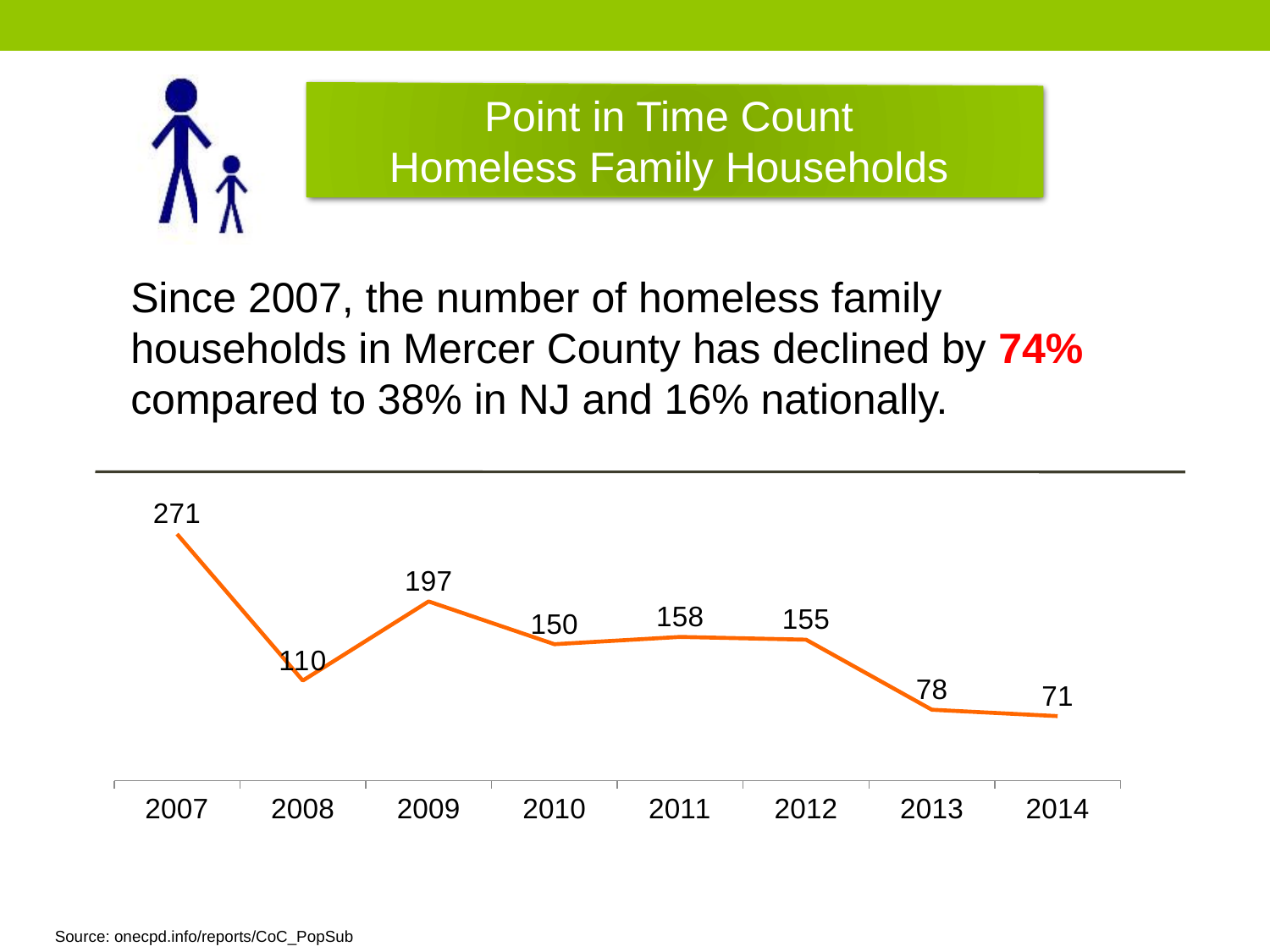
Which year has a larger value, 2010 or 2012? 2012 What is the difference between the 2009 value and the 2008 value? 87 What colour is the line in the chart? orange Which year has the highest number of homeless family households? 2007 What type of chart is shown on the slide? line chart What is the difference between the 2007 value and the 2014 value? 200 How many years are plotted on the chart? 8 What was the number of homeless family households in 2007? 271 What was the number of homeless family households in 2014? 71 Overall, do the values rise or fall from 2007 to 2014? fall What was the number of homeless family households in 2011? 158 Which year has the lowest number of homeless family households? 2014